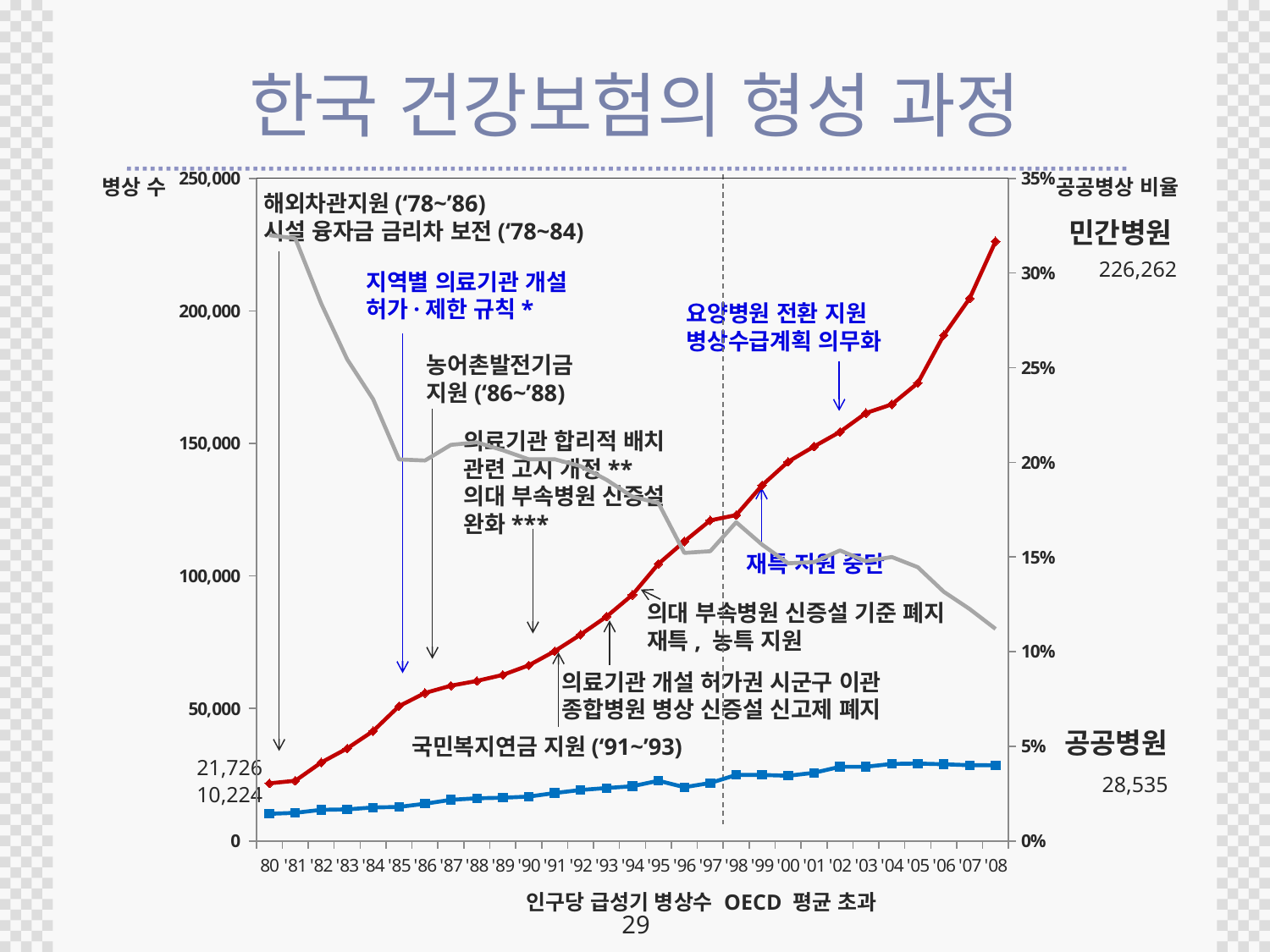
What is the number of 민간병원 beds in '08? 226,262 What kind of chart is shown on the slide? line chart What is the difference between the 민간병원 and 공공병원 bed counts in '08? 197,727 Which series has the larger value in '08, 민간병원 or 공공병원? 민간병원 Is the 민간병원 value in '95 greater or less than 100,000? greater What is the label of the right-hand vertical axis? 공공병상 비율 What is the number of 민간병원 beds in '80? 21,726 What is the number of 공공병원 beds in '80? 10,224 Does the 민간병원 line rise or fall from '80 to '08? rise Is the 공공병상 비율 (gray line) value in '08 greater or less than 15%? less What is the number of 공공병원 beds in '08? 28,535 By how much did the 민간병원 bed count increase from '80 to '08? 204,536